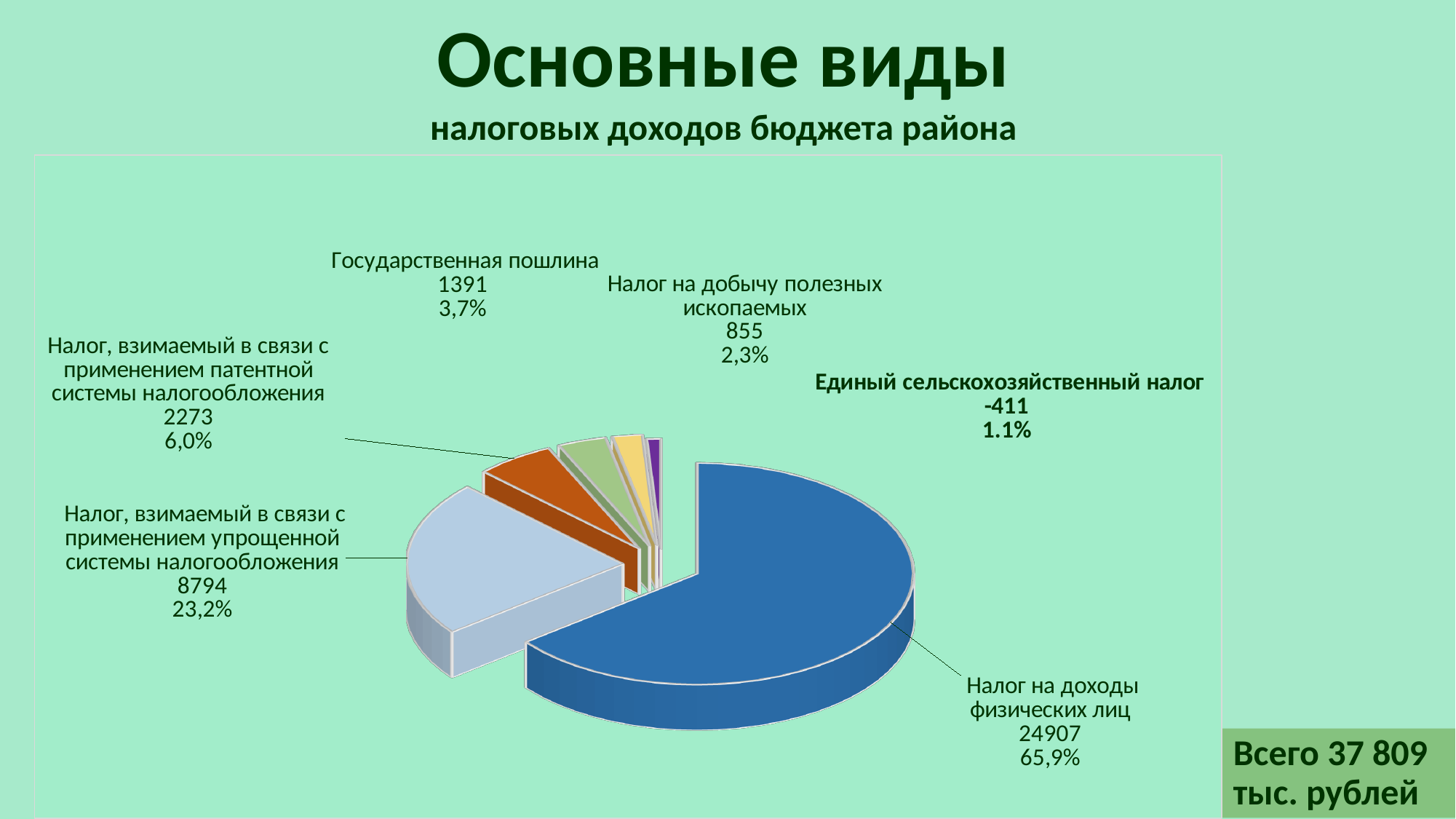
What share of the pie does Налог на доходы физических лиц represent? 65,9% Which category has the largest slice of the pie? Налог на доходы физических лиц What is the value for Единый сельскохозяйственный налог? -411 What is the difference between the values for Налог на доходы физических лиц and Налог, взимаемый в связи с применением упрощенной системы налогообложения? 16113 What is the value for Государственная пошлина? 1391 What kind of chart is shown on the slide? pie chart What is the value for Налог на доходы физических лиц? 24907 Which is larger: the value for Налог, взимаемый в связи с применением патентной системы налогообложения or the value for Государственная пошлина? Налог, взимаемый в связи с применением патентной системы налогообложения Which category has the smallest value? Единый сельскохозяйственный налог What is the value for Налог на добычу полезных ископаемых? 855 What is the value for Налог, взимаемый в связи с применением упрощенной системы налогообложения? 8794 How many categories (slices) does the pie chart show? 6